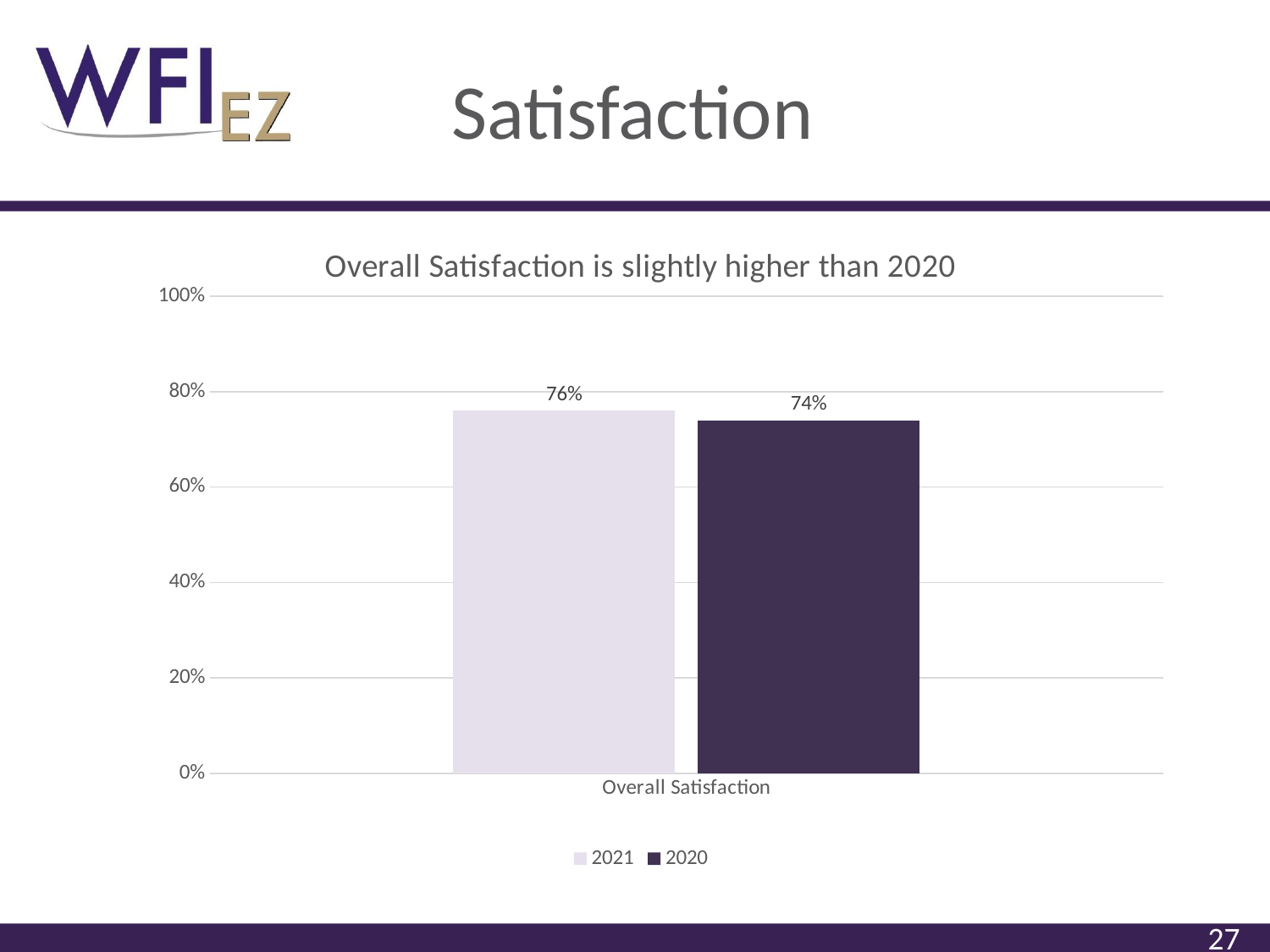
What is the Overall Satisfaction value for 2020? 74% How many categories are shown on the x axis? 1 Which year has the higher Overall Satisfaction, 2021 or 2020? 2021 Which series is shown in the darker purple colour? 2020 Is the Overall Satisfaction value for 2020 greater or less than 80%? less What is the highest value shown on the y axis? 100% What is the difference between the 2021 and 2020 Overall Satisfaction values? 2% What is the Overall Satisfaction value for 2021? 76% What is the title of the chart? Overall Satisfaction is slightly higher than 2020 What kind of chart is shown on the slide? bar chart Is the Overall Satisfaction value for 2021 greater or less than 60%? greater How many series does the legend list? 2